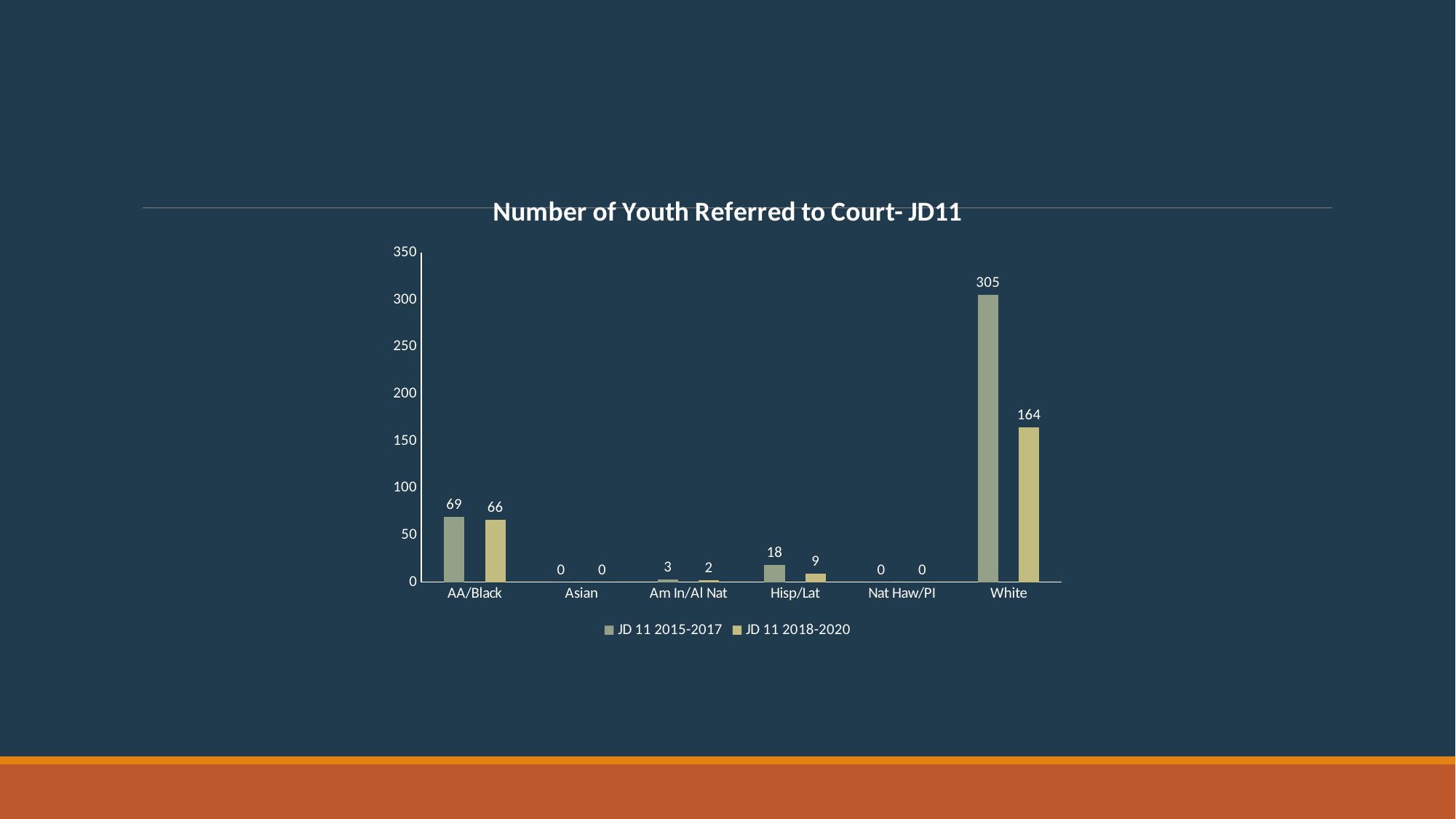
What is the difference between the JD 11 2015-2017 and JD 11 2018-2020 values for Hisp/Lat? 9 How many categories are shown on the x axis? 6 What is the difference between the JD 11 2015-2017 and JD 11 2018-2020 values for White? 141 Which is larger: the JD 11 2015-2017 value for AA/Black or the JD 11 2018-2020 value for AA/Black? JD 11 2015-2017 What is the value for White in the JD 11 2015-2017 series? 305 What is the value for AA/Black in the JD 11 2018-2020 series? 66 Is the value for White in the JD 11 2018-2020 series greater or less than 150? greater Which category has the highest value in the JD 11 2018-2020 series? White What is the value for Hisp/Lat in the JD 11 2015-2017 series? 18 What is the title of the chart? Number of Youth Referred to Court- JD11 What kind of chart is shown on the slide? Bar chart How many series does the legend list? 2